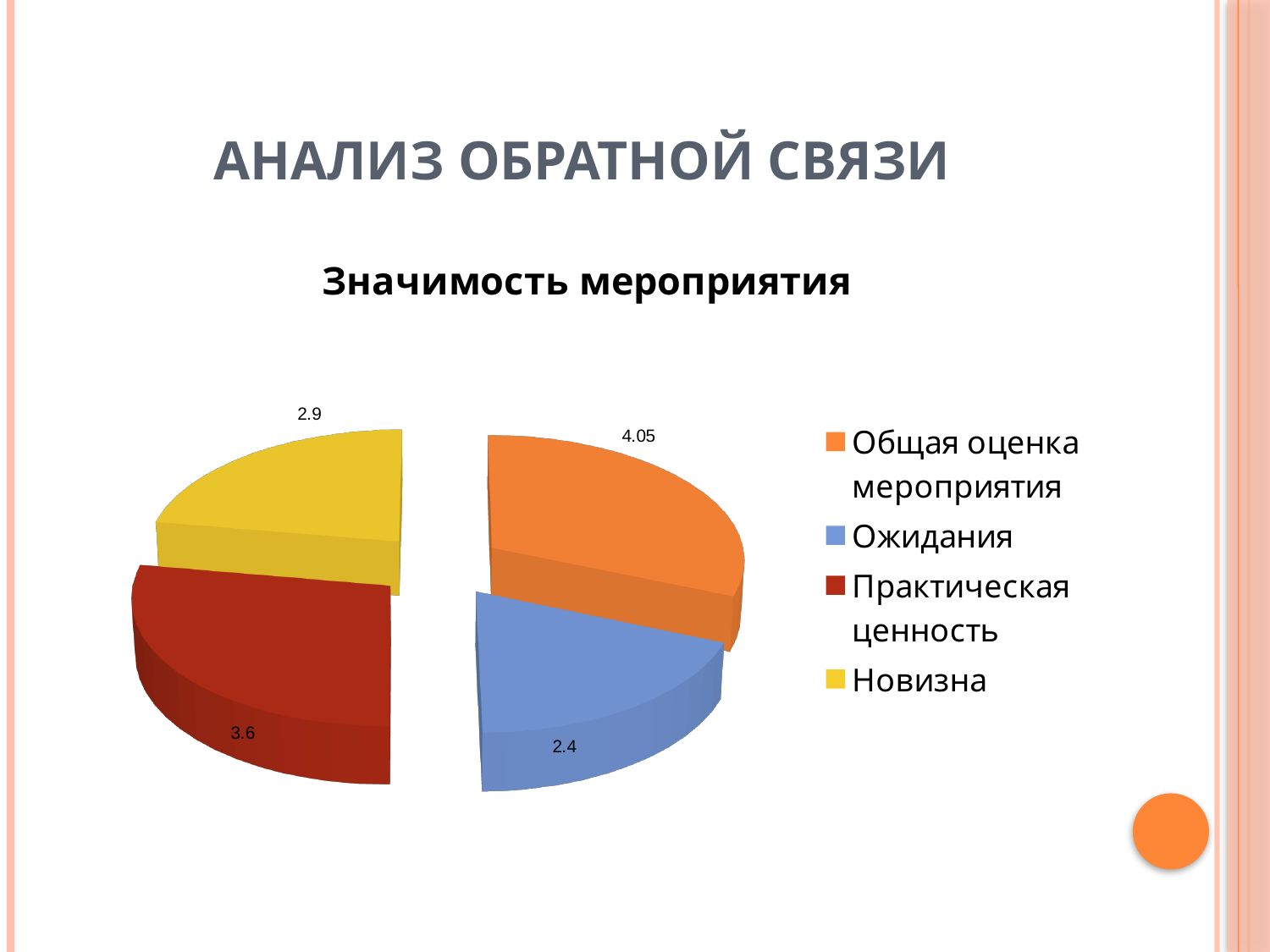
Which category has the lowest value? Ожидания What is the title of the chart? Значимость мероприятия What is the value for Практическая ценность? 3.6 What is the difference between the values for Практическая ценность and Новизна? 0.7 Which category has the highest value? Общая оценка мероприятия What is the difference between the values for Общая оценка мероприятия and Ожидания? 1.65 What type of chart is shown on the slide? pie chart How many categories does the legend list? 4 What is the value for Общая оценка мероприятия? 4.05 What is the value for Ожидания? 2.4 What is the value for Новизна? 2.9 Which is larger, the value for Практическая ценность or the value for Новизна? Практическая ценность